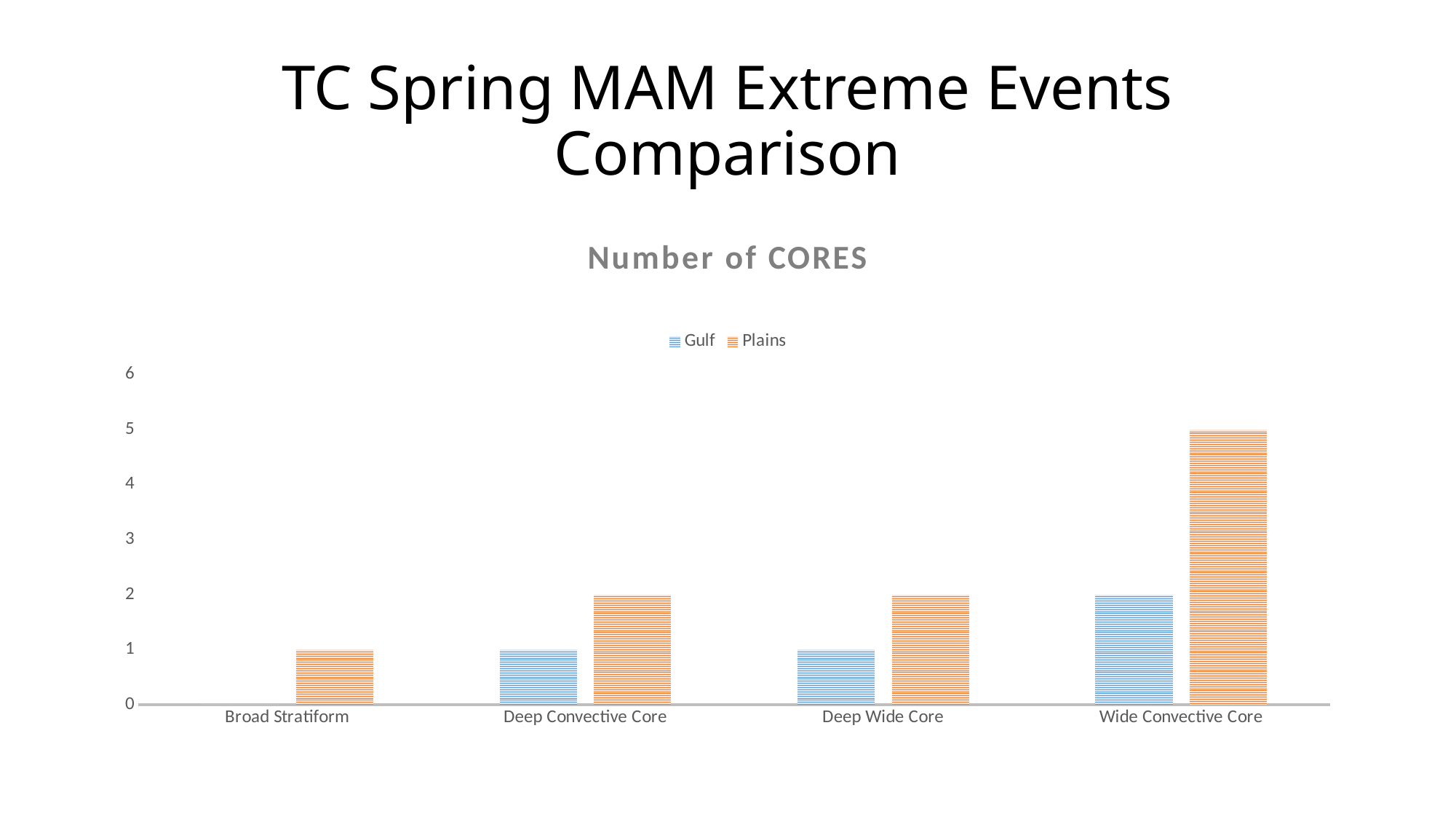
Which category has the highest Plains value? Wide Convective Core What is the title of the chart? Number of CORES What is the Gulf value for Deep Convective Core? 1 For Deep Wide Core, which series has the larger value, Gulf or Plains? Plains Which category has the lowest Gulf value? Broad Stratiform What is the Plains value for Broad Stratiform? 1 What is the Plains value for Wide Convective Core? 5 How many categories are shown on the x axis? 4 How many series does the legend list? 2 What is the difference between the Plains and Gulf values for Wide Convective Core? 3 What kind of chart is shown on the slide? bar chart What is the Gulf value for Wide Convective Core? 2